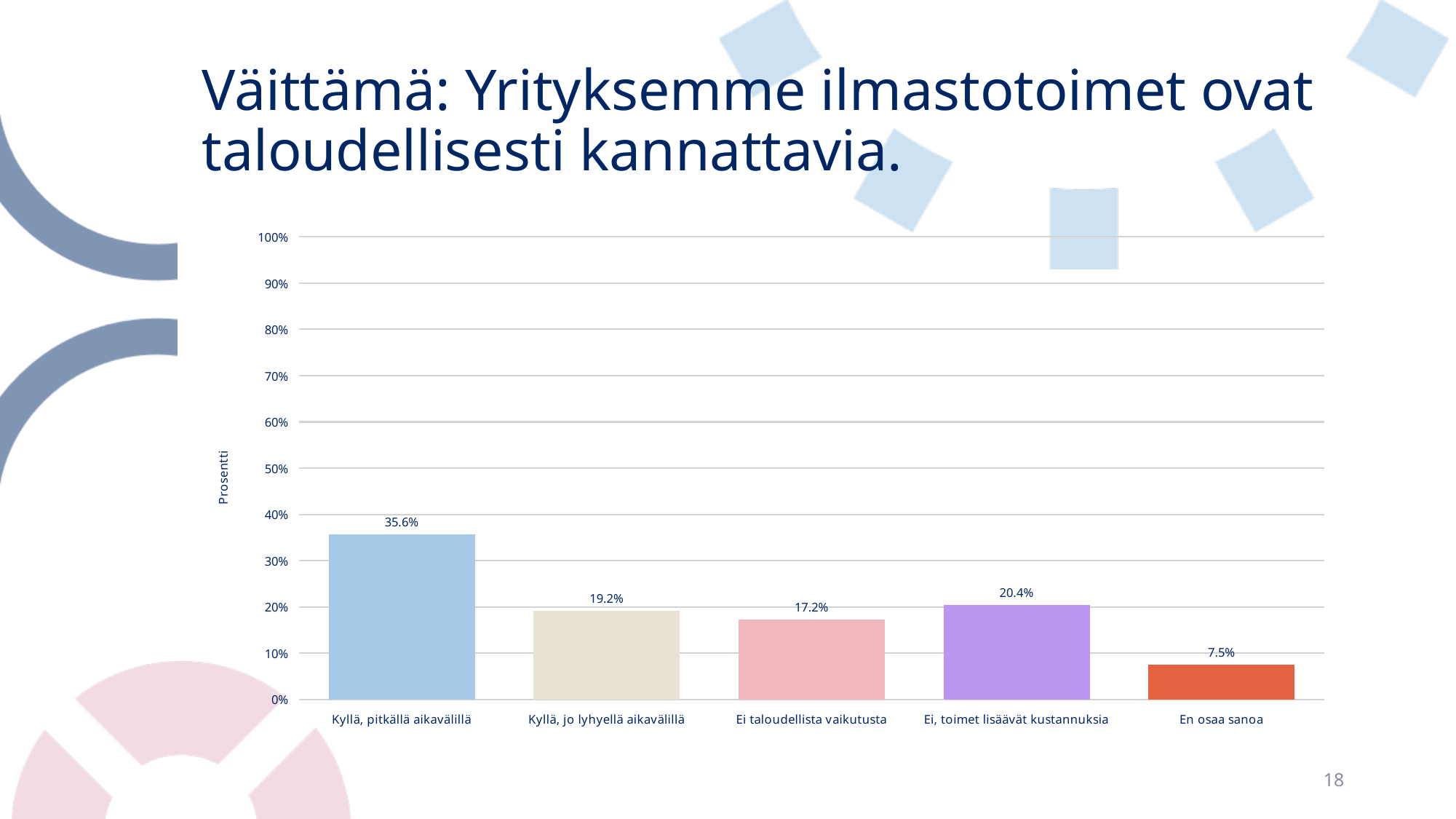
What is the difference between the values for "Kyllä, pitkällä aikavälillä" and "Kyllä, jo lyhyellä aikavälillä"? 16.4% Which is larger, the value for "Kyllä, jo lyhyellä aikavälillä" or the value for "Ei taloudellista vaikutusta"? Kyllä, jo lyhyellä aikavälillä What is the value for "En osaa sanoa"? 7.5% What is the difference between the values for "Ei, toimet lisäävät kustannuksia" and "Ei taloudellista vaikutusta"? 3.2% What is the label of the vertical axis? Prosentti Is the value for "Kyllä, pitkällä aikavälillä" greater or less than 30%? greater Which category has the lowest value? En osaa sanoa What is the value for "Ei, toimet lisäävät kustannuksia"? 20.4% Which category has the highest value? Kyllä, pitkällä aikavälillä What kind of chart is shown on the slide? Bar chart How many categories are shown on the x axis? 5 What is the value for "Kyllä, pitkällä aikavälillä"? 35.6%